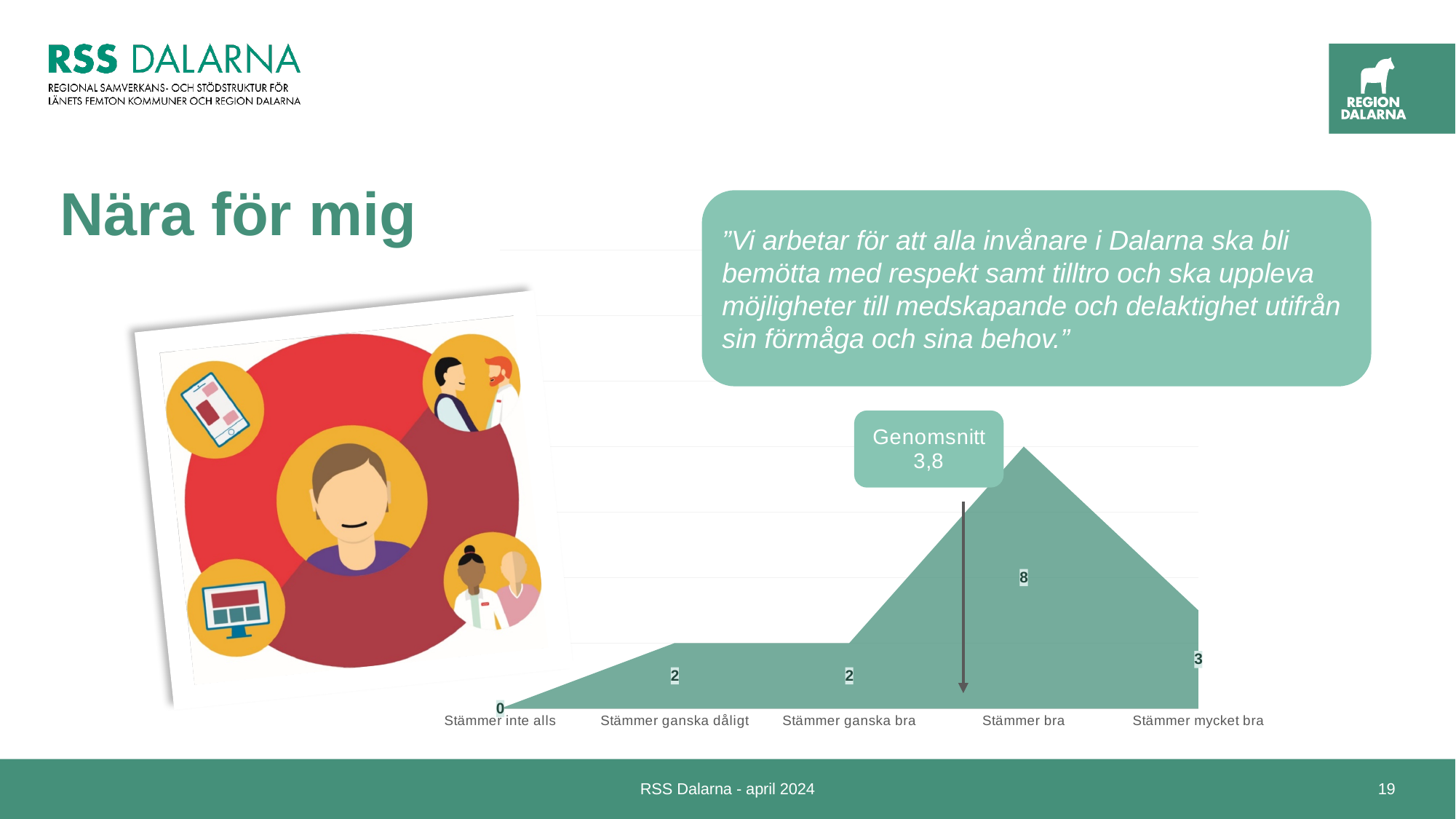
What is the value for "Stämmer inte alls"? 0 What kind of chart is shown on the slide? Area chart What is the total of all the values plotted in the chart? 15 How many categories are shown on the x axis of the chart? 5 What is the value for "Stämmer mycket bra"? 3 What average (Genomsnitt) value is shown in the label above the chart? 3,8 Which category has the lowest value? Stämmer inte alls Which category has the highest value? Stämmer bra What is the value for "Stämmer bra"? 8 What is the difference between the values for "Stämmer bra" and "Stämmer mycket bra"? 5 What is the value for "Stämmer ganska dåligt"? 2 Which is larger, the value for "Stämmer ganska bra" or the value for "Stämmer mycket bra"? Stämmer mycket bra